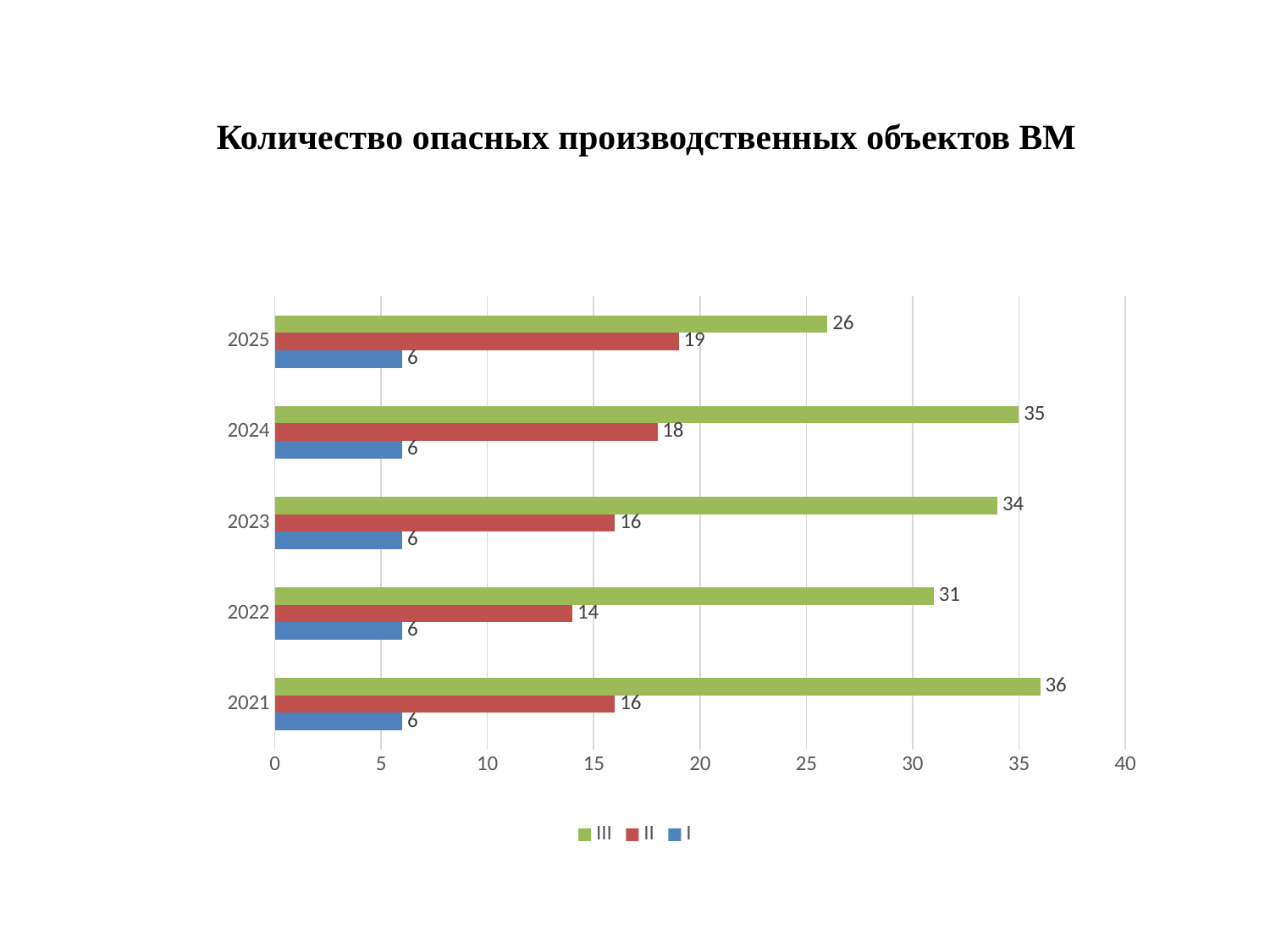
Which is larger: series III in 2022 or series III in 2025? series III in 2022 How many years are shown on the chart? 5 What is the value for series I in 2021? 6 In which year is the value for series II highest? 2025 How many series does the legend list? 3 What kind of chart is shown on the slide? bar chart What is the title of the chart? Количество опасных производственных объектов ВМ In which year is the value for series III highest? 2021 What is the difference between series III and series II in 2023? 18 In which year is the value for series III lowest? 2025 What is the value for series II in 2022? 14 What is the value for series III in 2024? 35